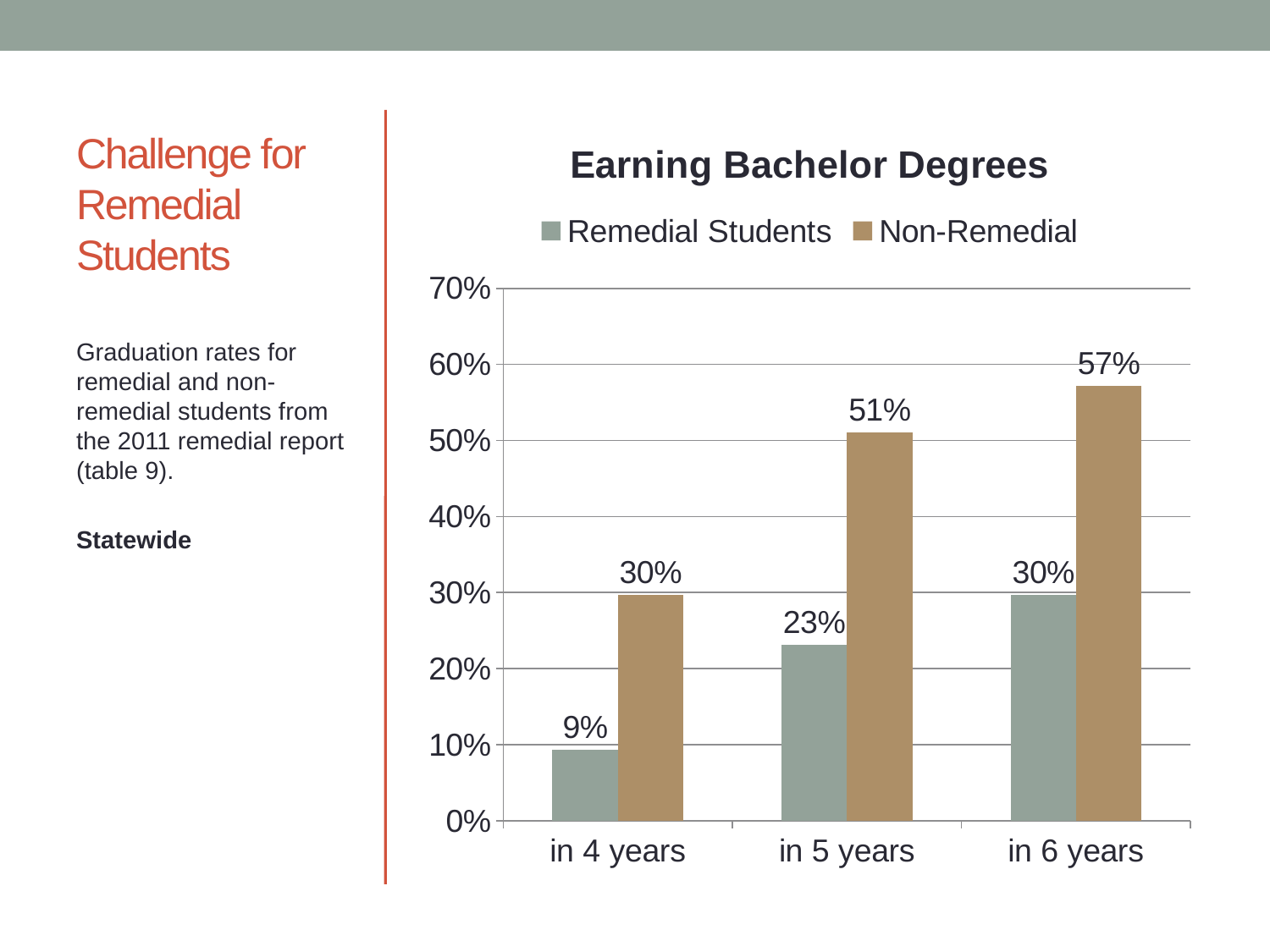
What kind of chart is shown? Bar chart What is the value for Remedial Students in 6 years? 30% Which is larger: the Remedial Students value in 5 years or the Non-Remedial value in 4 years? Non-Remedial in 4 years What is the value for Remedial Students in 4 years? 9% Which category has the highest Non-Remedial value? in 6 years Do the Remedial Students values rise or fall from 4 years to 6 years? Rise How many series does the legend list? 2 How many categories are shown on the x axis? 3 What is the title of the chart? Earning Bachelor Degrees What is the value for Non-Remedial in 5 years? 51% Which category has the lowest Remedial Students value? in 4 years What is the difference between the Non-Remedial and Remedial Students values in 6 years? 27%